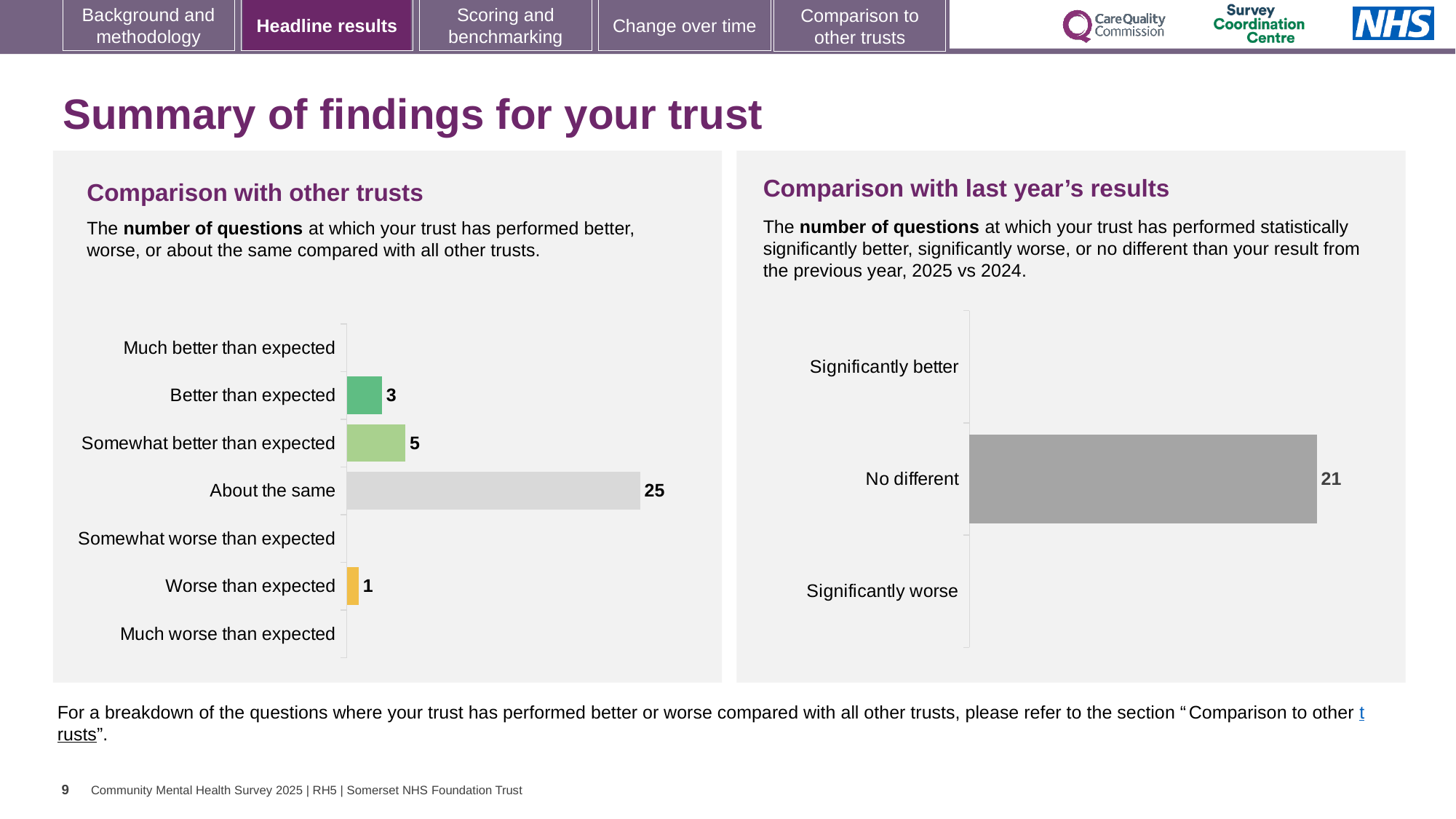
How many categories are listed on the axis of the 'Comparison with last year's results' chart? 3 In the 'Comparison with other trusts' chart, what colour is the bar for 'Worse than expected'? Yellow/orange In the 'Comparison with other trusts' chart, what is the difference between 'About the same' and 'Somewhat better than expected'? 20 What type of chart is the 'Comparison with last year's results' chart? Bar chart In the 'Comparison with other trusts' chart, which category has the highest value? About the same In the 'Comparison with last year's results' chart, what is the value for 'No different'? 21 In the 'Comparison with other trusts' chart, what is the value for 'Worse than expected'? 1 In the 'Comparison with other trusts' chart, what is the value for 'Somewhat better than expected'? 5 In the 'Comparison with other trusts' chart, what is the value for 'About the same'? 25 How many categories are listed on the axis of the 'Comparison with other trusts' chart? 7 In the 'Comparison with other trusts' chart, which is larger: 'Better than expected' or 'Somewhat better than expected'? Somewhat better than expected In the 'Comparison with other trusts' chart, what is the value for 'Better than expected'? 3